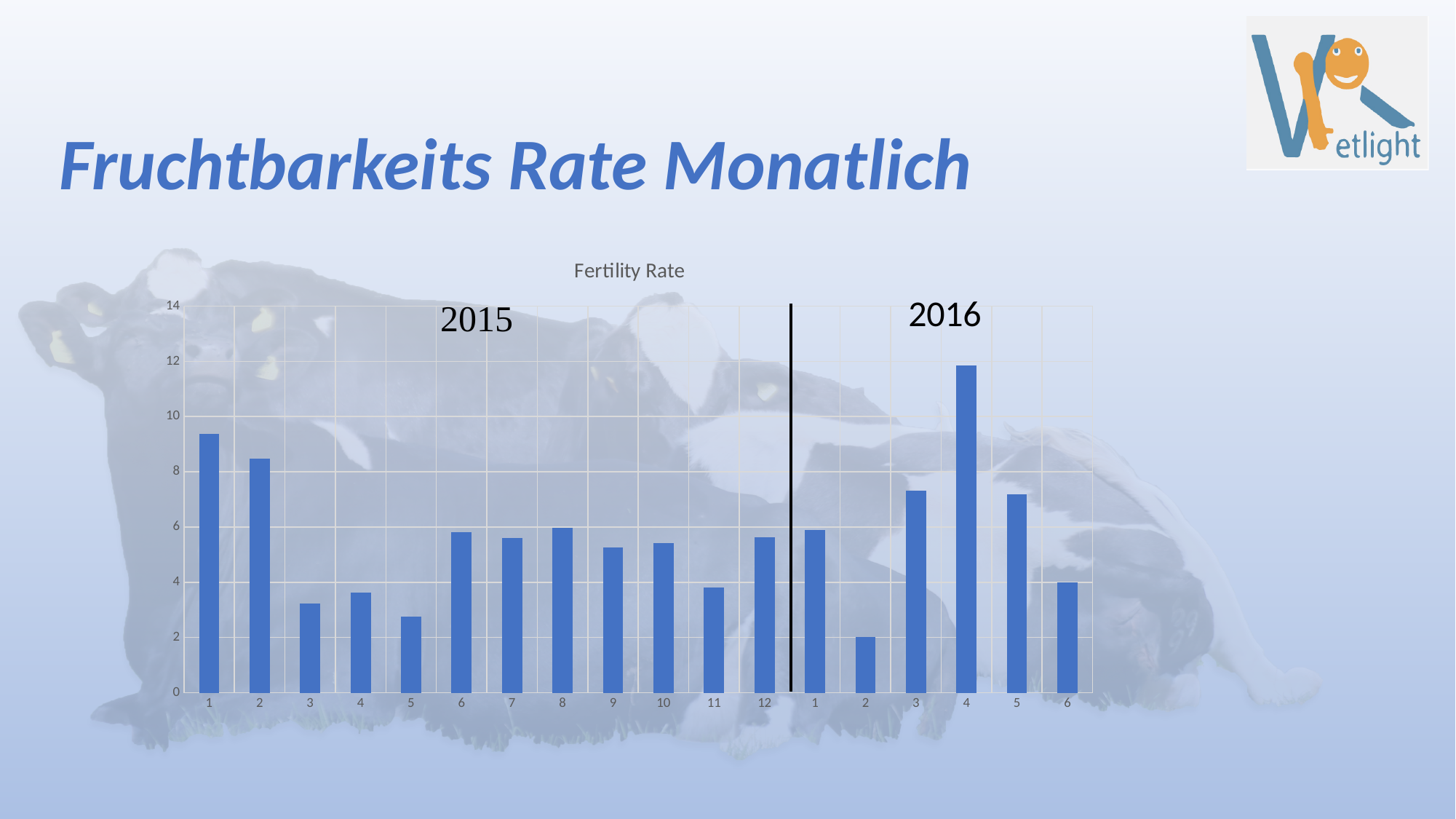
What kind of chart is shown on the slide? bar chart How many bars are plotted in the chart in total? 18 Is the value for month 4 of 2016 greater or less than 10? greater Is the value for month 3 of 2016 greater or less than 6? greater Is the value for month 1 of 2015 greater or less than 8? greater What is the title of the chart? Fertility Rate How many months of 2016 are shown in the chart? 6 Which bar is the highest in the chart? Month 4 of 2016 Which is larger, the value for month 1 of 2015 or the value for month 1 of 2016? Month 1 of 2015 Which bar is the lowest in the chart? Month 2 of 2016